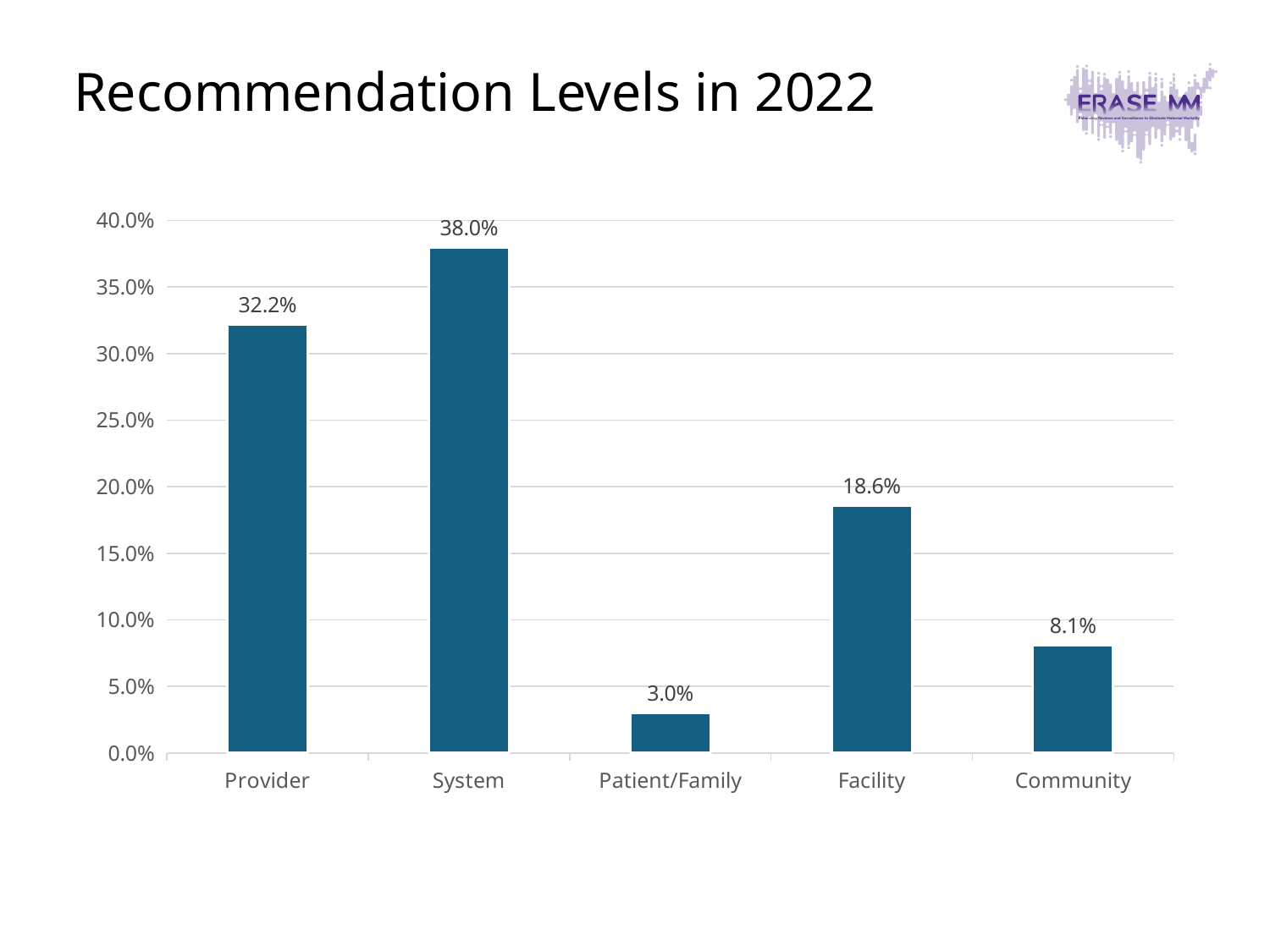
How many categories are shown on the x axis? 5 What is the difference between the values for Facility and Community? 10.5% What is the value for Community? 8.1% What kind of chart is shown on the slide? bar chart What is the title of the slide? Recommendation Levels in 2022 What is the value for Patient/Family? 3.0% What is the difference between the values for System and Provider? 5.8% What is the value for Provider? 32.2% Which category has the highest value? System Which is larger, the value for Facility or the value for Community? Facility Is the value for Facility greater or less than 20.0%? less Which category has the lowest value? Patient/Family